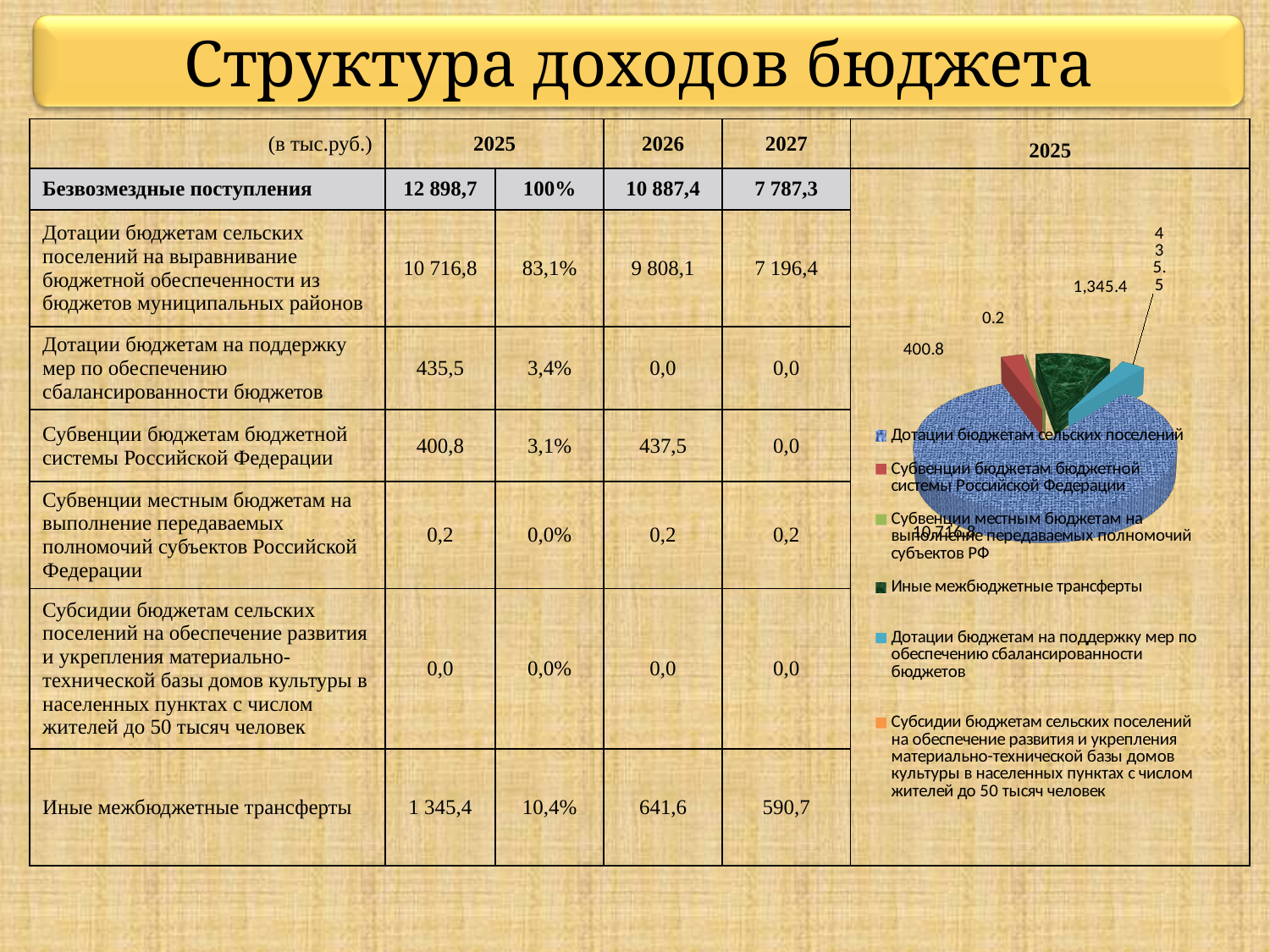
In the pie chart, what value is labelled for Субвенции местным бюджетам на выполнение передаваемых полномочий субъектов РФ? 0.2 What is the title of the pie chart? 2025 In the pie chart, what value is labelled for Дотации бюджетам на поддержку мер по обеспечению сбалансированности бюджетов? 435.5 Which category has the largest slice in the pie chart? Дотации бюджетам сельских поселений What colour is the largest slice of the pie chart? blue What kind of chart is shown on the right side of the slide? pie chart In the pie chart, which is larger: Иные межбюджетные трансферты or Субвенции бюджетам бюджетной системы Российской Федерации? Иные межбюджетные трансферты In the pie chart, what is the difference between the values for Дотации бюджетам на поддержку мер по обеспечению сбалансированности бюджетов (435.5) and Субвенции бюджетам бюджетной системы Российской Федерации (400.8)? 34.7 How many categories does the pie chart's legend list? 6 In the pie chart, what value is labelled for Иные межбюджетные трансферты? 1,345.4 In the pie chart, what value is labelled for Субвенции бюджетам бюджетной системы Российской Федерации? 400.8 In the pie chart, what is the difference between the values for Иные межбюджетные трансферты (1,345.4) and Субвенции бюджетам бюджетной системы Российской Федерации (400.8)? 944.6